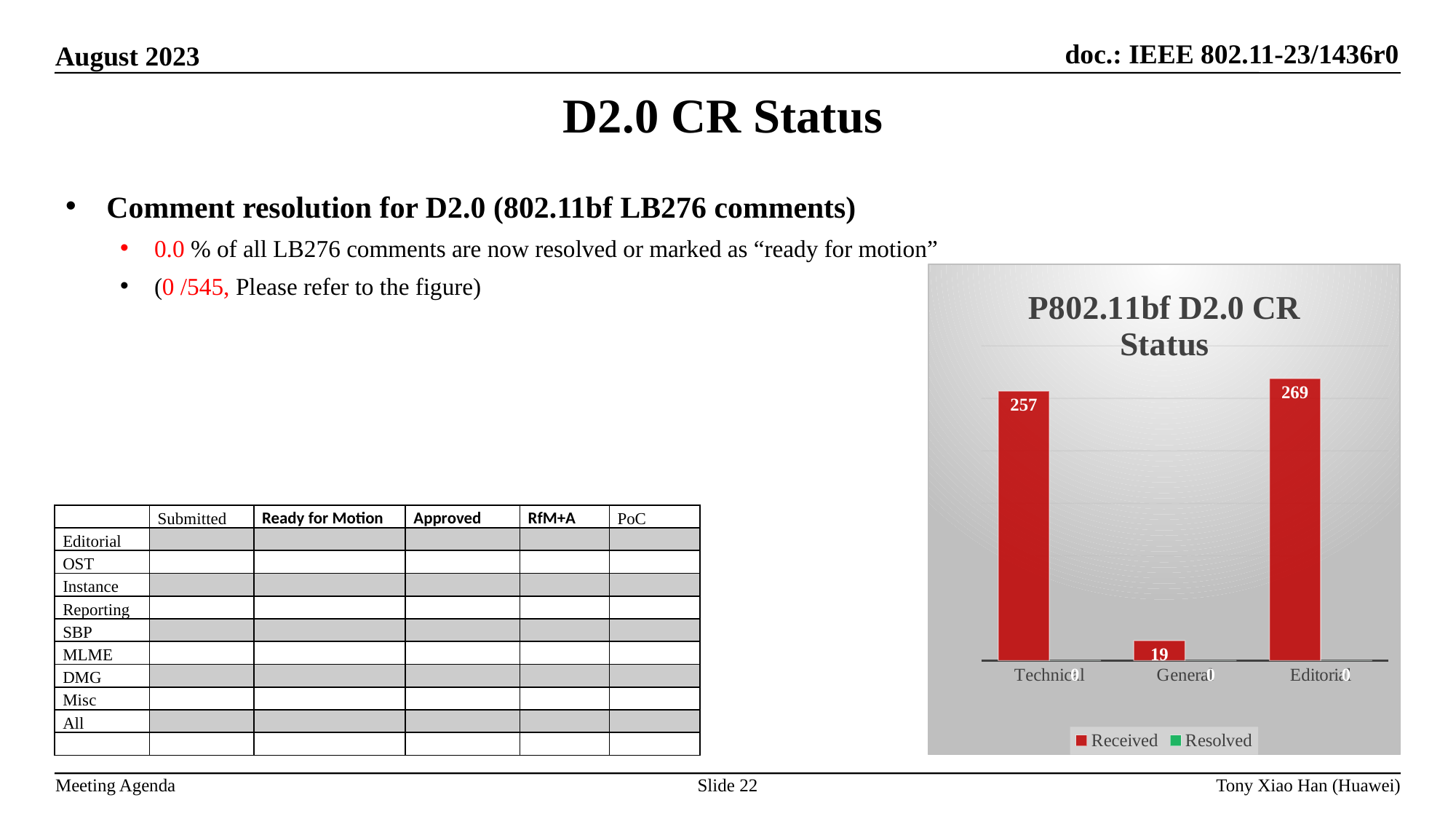
Which category has the highest Received value? Editorial Which is larger, the Received value for Technical or for General? Technical What is the difference between the Received values for Editorial and Technical? 12 How many categories are shown on the x axis of the chart? 3 What is the Received value for Technical? 257 How many series does the chart legend list? 2 What type of chart is shown on the slide? bar chart Which category has the lowest Received value? General What is the title of the chart on the slide? P802.11bf D2.0 CR Status Which series are listed in the chart legend? Received and Resolved What is the Received value for Editorial? 269 What is the Received value for General? 19